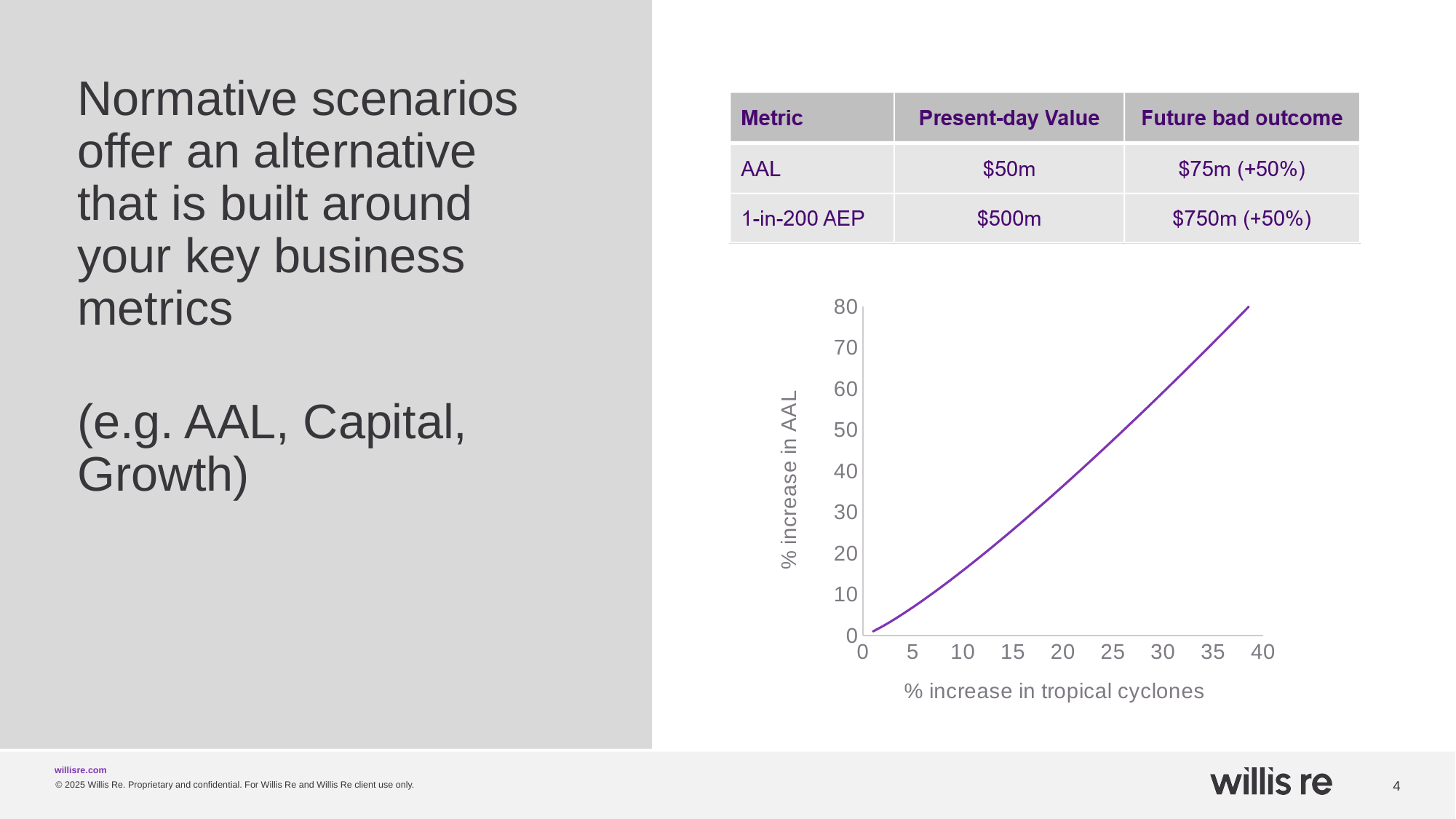
What is the label of the y axis of the chart? % increase in AAL Is the % increase in AAL at a 30% increase in tropical cyclones greater or less than 50? greater Is the % increase in AAL at a 10% increase in tropical cyclones greater or less than 20? less Is the % increase in AAL at a 35% increase in tropical cyclones greater or less than 60? greater What kind of chart is shown on the slide? line chart What is the label of the x axis of the chart? % increase in tropical cyclones Is the % increase in AAL at a 20% increase in tropical cyclones greater or less than the value at a 10% increase? greater How many lines (series) are plotted on the chart? 1 Does the % increase in AAL rise or fall as the % increase in tropical cyclones grows along the x axis? rise